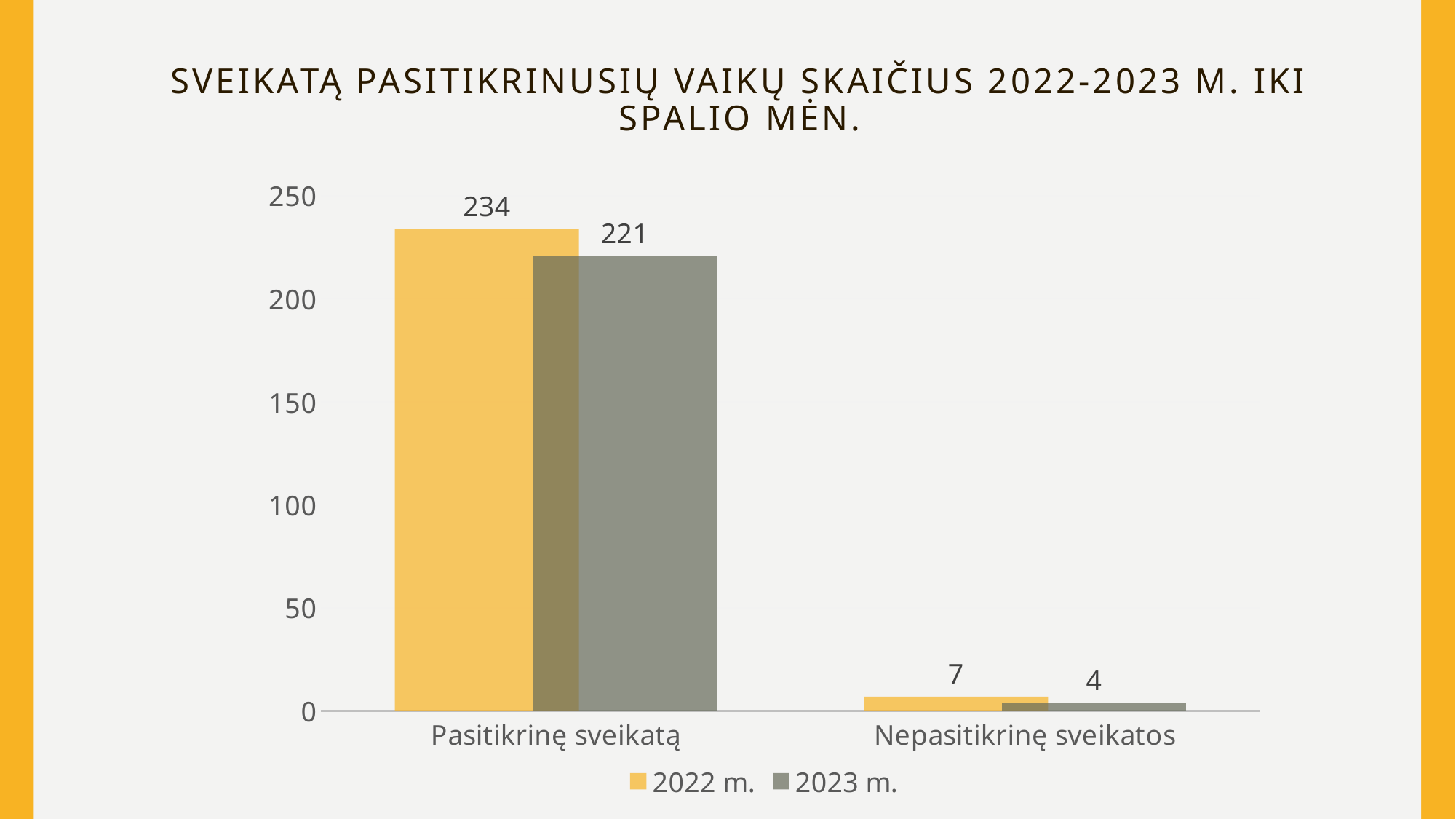
What is the value for 'Nepasitikrinę sveikatos' in the 2023 m. series? 4 Is the 2023 m. value for 'Pasitikrinę sveikatą' greater or less than 200? greater What is the value for 'Nepasitikrinę sveikatos' in the 2022 m. series? 7 What kind of chart is shown on the slide? Bar chart Which category has the highest value in the 2022 m. series? Pasitikrinę sveikatą What is the difference between the 2022 m. and 2023 m. values for 'Pasitikrinę sveikatą'? 13 How many series does the legend list? 2 Which category has the lowest value in the 2023 m. series? Nepasitikrinę sveikatos What is the value for 'Pasitikrinę sveikatą' in the 2023 m. series? 221 What is the value for 'Pasitikrinę sveikatą' in the 2022 m. series? 234 Which is larger for 'Nepasitikrinę sveikatos': the 2022 m. value or the 2023 m. value? 2022 m. How many categories are shown on the x axis? 2